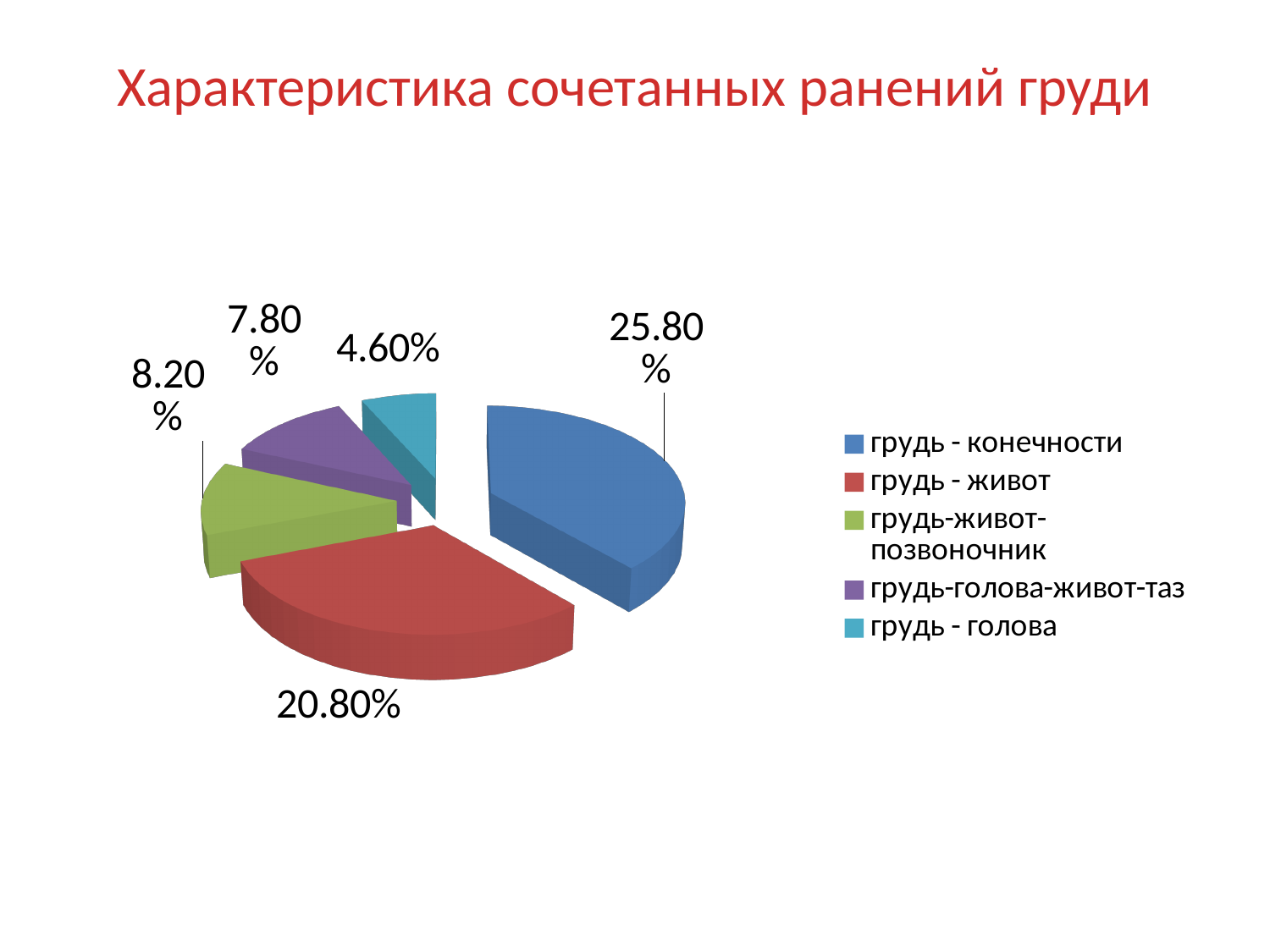
What is the value shown for грудь - конечности? 25.80% What is the difference between the values for грудь - конечности and грудь - живот? 5.00% How many slices does the pie chart have? 5 Which is larger, the value for грудь-живот-позвоночник or the value for грудь - голова? грудь-живот-позвоночник Which category has the smallest slice? грудь - голова What is the title of the slide? Характеристика сочетанных ранений груди What is the value shown for грудь - голова? 4.60% Which category has the largest slice? грудь - конечности What is the value shown for грудь-живот-позвоночник? 8.20% What is the value shown for грудь-голова-живот-таз? 7.80% What is the value shown for грудь - живот? 20.80% What kind of chart is shown on the slide? pie chart